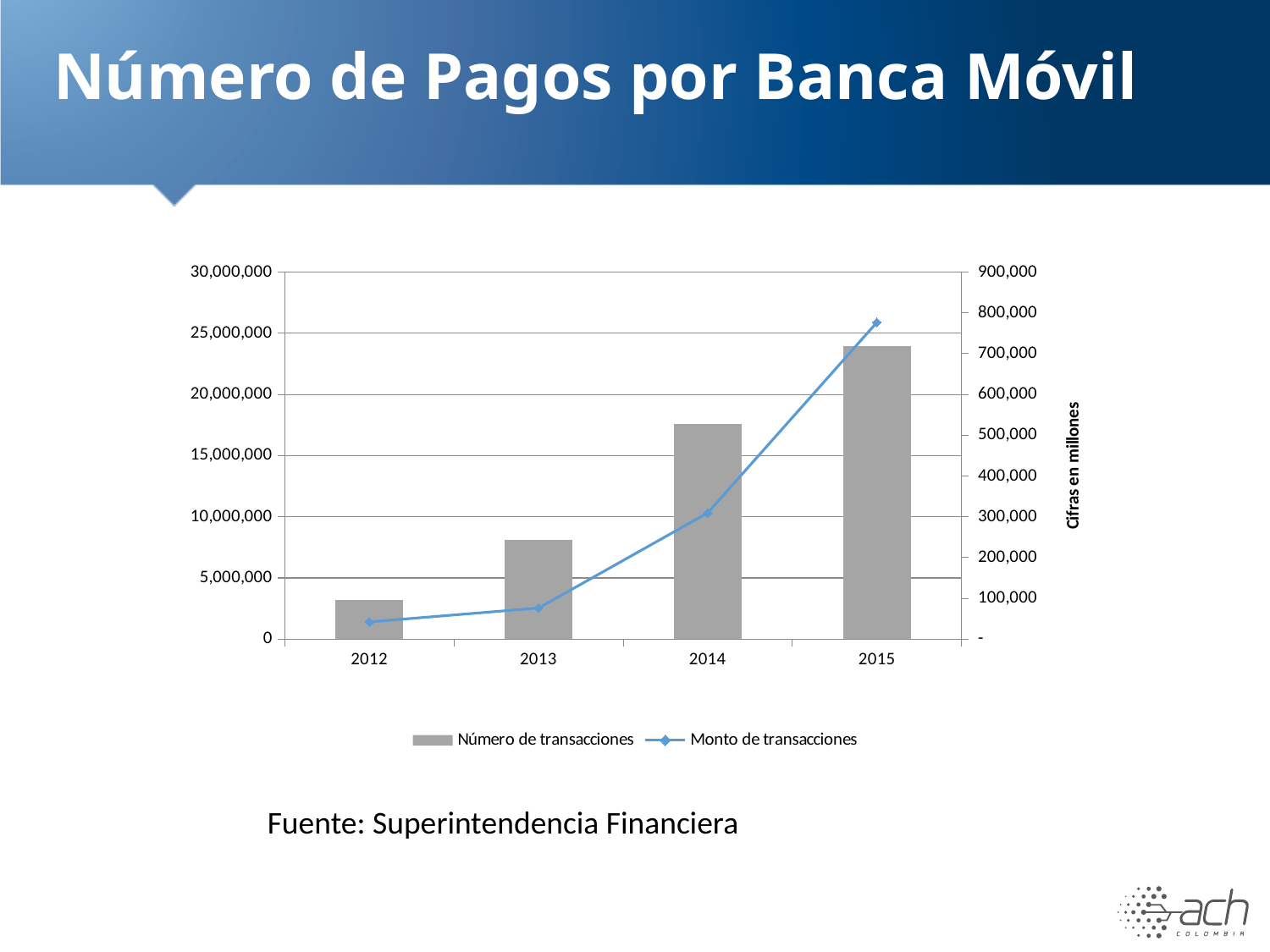
Is the Número de transacciones for 2012 greater or less than 5,000,000? less How many series does the legend list? 2 Is the Monto de transacciones for 2015 greater or less than 700,000? greater How many years are shown on the x axis? 4 Which year has the lowest Número de transacciones? 2012 Which year has the highest Número de transacciones? 2015 Is the Número de transacciones for 2015 greater or less than 20,000,000? greater What kind of chart is shown on the slide? A combined bar and line chart Do the values of Monto de transacciones rise or fall from 2012 to 2015? rise Which series is plotted as a line with diamond markers? Monto de transacciones